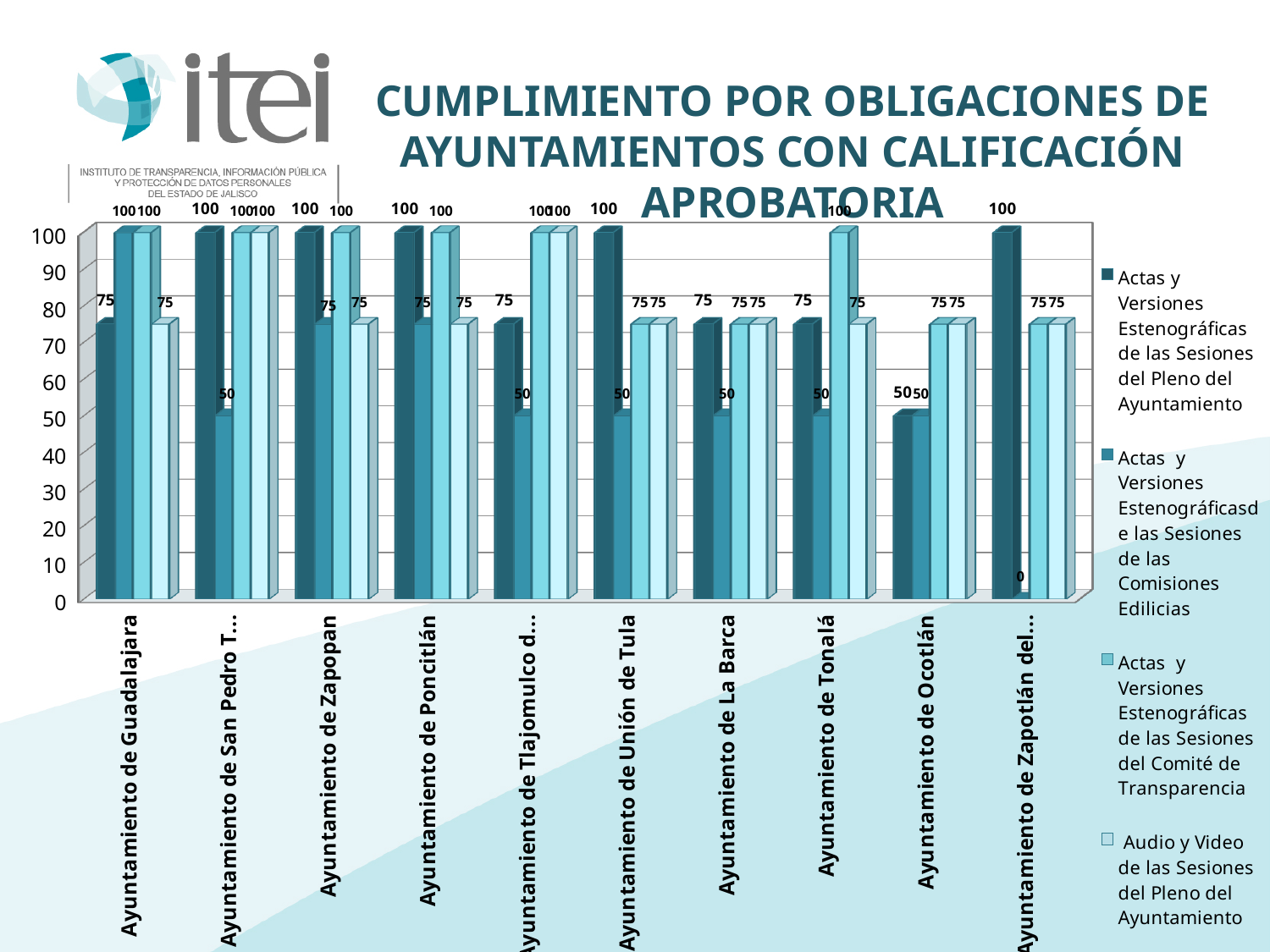
What is the value for Ayuntamiento de Zapotlán in the series 'Actas y Versiones Estenográficas de las Sesiones de las Comisiones Edilicias'? 0 What is the value for Ayuntamiento de Ocotlán in the series 'Actas y Versiones Estenográficas de las Sesiones del Pleno del Ayuntamiento'? 50 Which ayuntamiento has the lowest value in the series 'Actas y Versiones Estenográficas de las Sesiones de las Comisiones Edilicias'? Ayuntamiento de Zapotlán What is the value for Ayuntamiento de Tonalá in the series 'Actas y Versiones Estenográficas de las Sesiones del Comité de Transparencia'? 100 How many series does the legend list? 4 What is the difference between the 'Actas y Versiones Estenográficas de las Sesiones del Pleno del Ayuntamiento' value for Ayuntamiento de Zapopan and that for Ayuntamiento de Ocotlán? 50 How many ayuntamientos (categories) are shown on the x axis? 10 What type of chart is shown on the slide? bar chart What is the value for Ayuntamiento de La Barca in the series 'Audio y Video de las Sesiones del Pleno del Ayuntamiento'? 75 What is the value for Ayuntamiento de Guadalajara in the series 'Actas y Versiones Estenográficas de las Sesiones del Pleno del Ayuntamiento'? 75 What is the title of the chart? CUMPLIMIENTO POR OBLIGACIONES DE AYUNTAMIENTOS CON CALIFICACIÓN APROBATORIA Which is larger for Ayuntamiento de Unión de Tula: the 'Sesiones del Pleno del Ayuntamiento' value or the 'Comisiones Edilicias' value? Sesiones del Pleno del Ayuntamiento